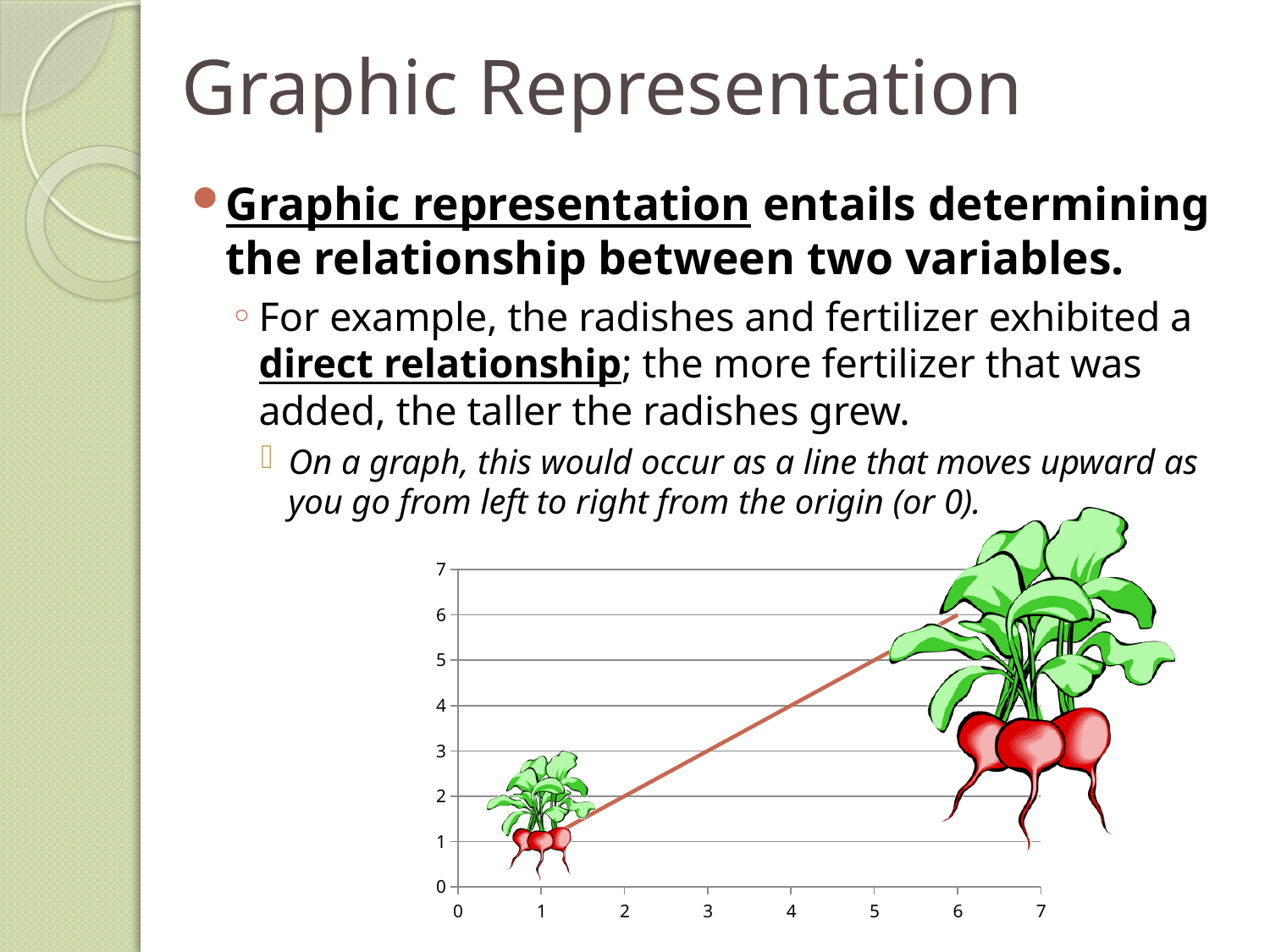
Do the values on the chart rise or fall as you move from left to right along the x axis? rise Is the value of the line at x = 2 greater or less than 5? less Is the value of the line at x = 5 greater or less than 3? greater What is the highest tick value shown on the x axis of the chart? 7 Is the value of the line at x = 1 greater or less than 3? less What is the highest tick value shown on the y axis of the chart? 7 What kind of chart is shown on the slide? line chart Is the value of the line higher at x = 6 or at x = 1? x = 6